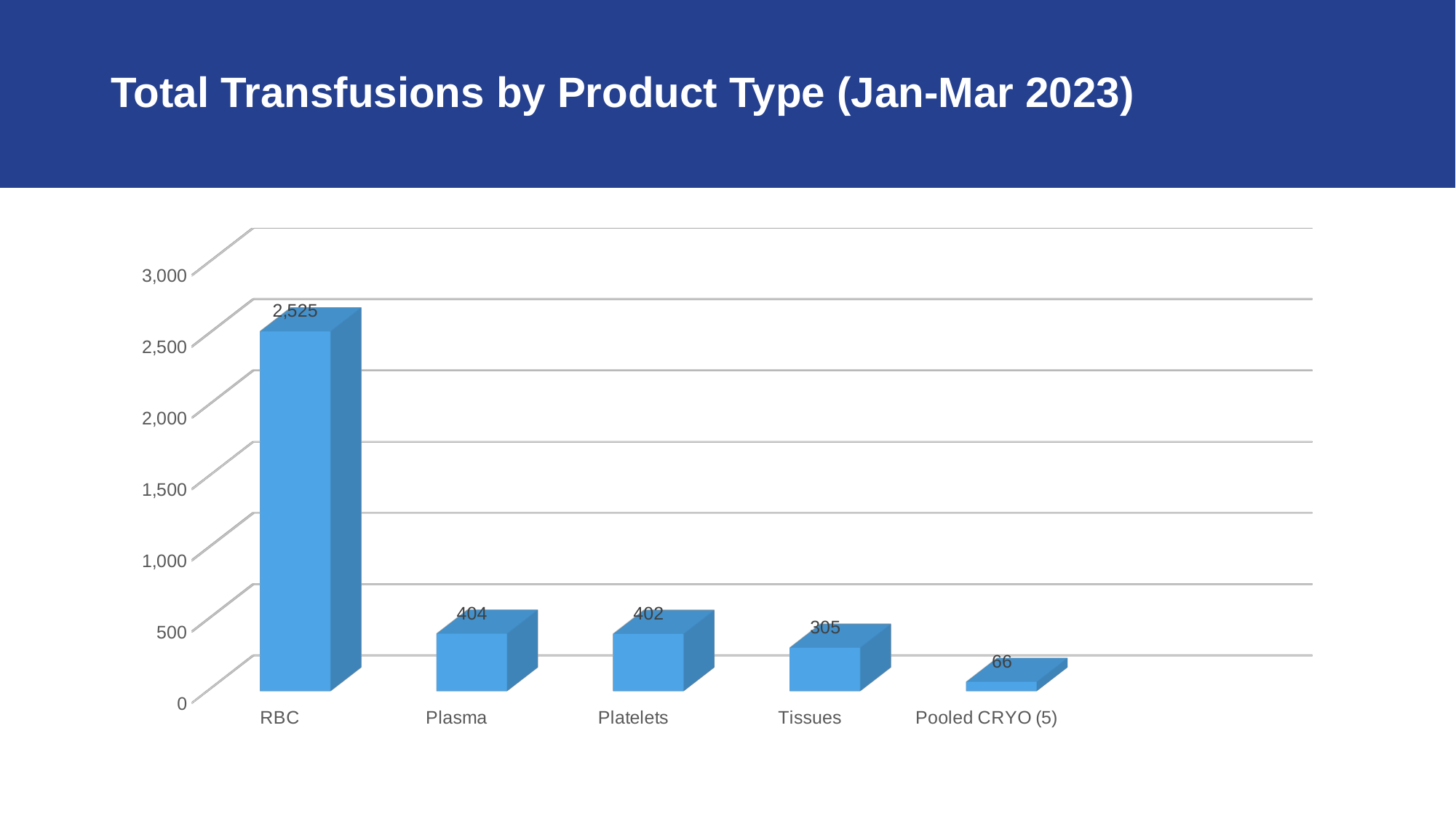
Is the value for RBC greater or less than 2,000? greater What kind of chart is shown on the slide? Bar chart What is the value for RBC? 2,525 Which product type has the lowest number of transfusions? Pooled CRYO (5) Which product type has the highest number of transfusions? RBC What is the difference between the values for RBC and Plasma? 2,121 What is the difference between the values for Platelets and Tissues? 97 How many product types are shown on the chart? 5 What is the value for Pooled CRYO (5)? 66 What is the value for Plasma? 404 What is the value for Tissues? 305 Which is larger, the value for Tissues or the value for Pooled CRYO (5)? Tissues